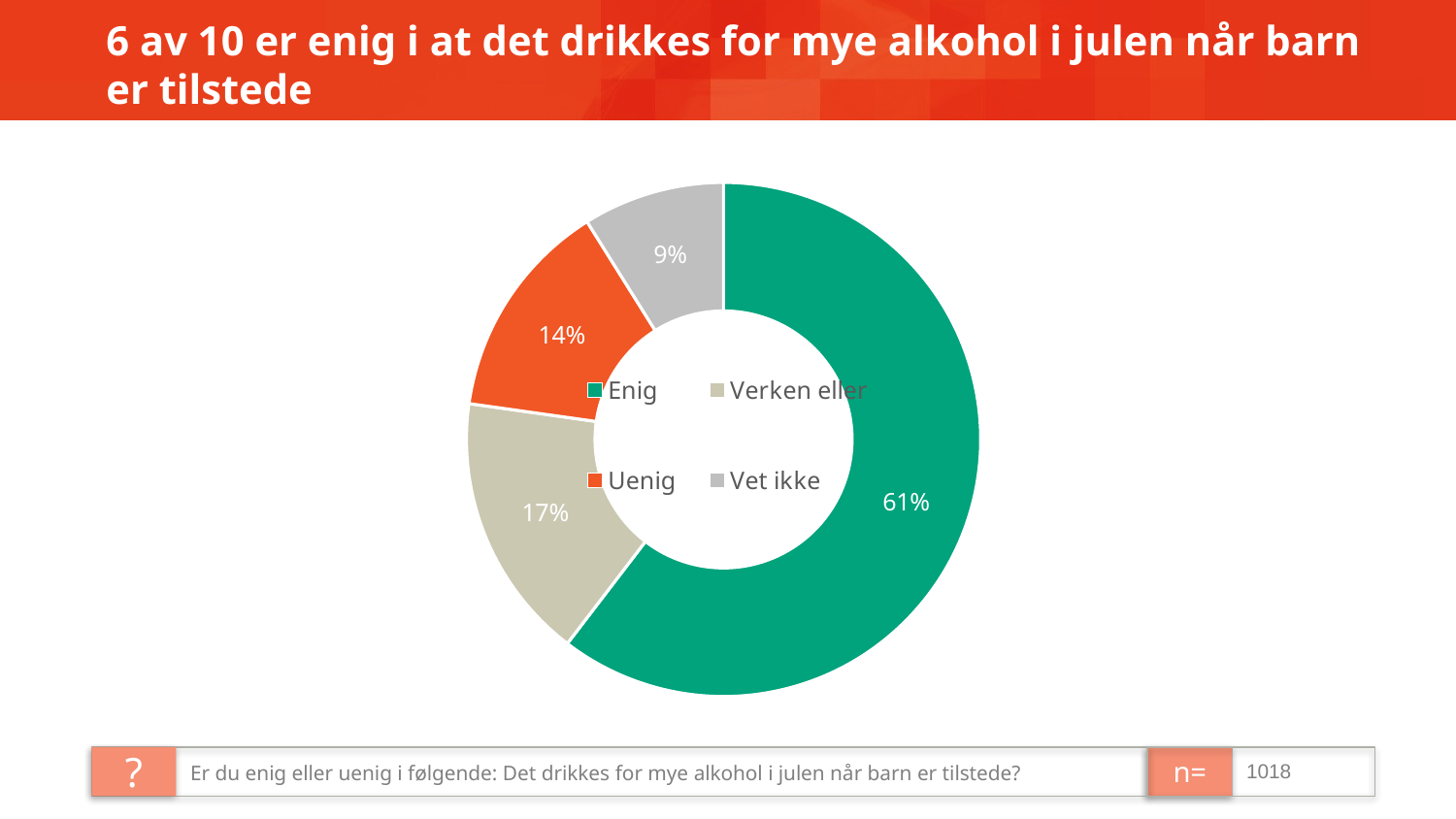
What percentage of respondents answered "Uenig"? 14% What percentage of respondents answered "Vet ikke"? 9% Which is larger, the share for "Verken eller" or the share for "Uenig"? Verken eller How many entries does the legend list? 4 Which response category has the largest share? Enig How many categories are shown in the chart? 4 Which response category has the smallest share? Vet ikke What percentage of respondents answered "Verken eller"? 17% What kind of chart is shown on the slide? Doughnut chart What is the sample size (n) shown on the slide? 1018 What is the difference in percentage points between "Enig" and "Uenig"? 47 What percentage of respondents answered "Enig"? 61%